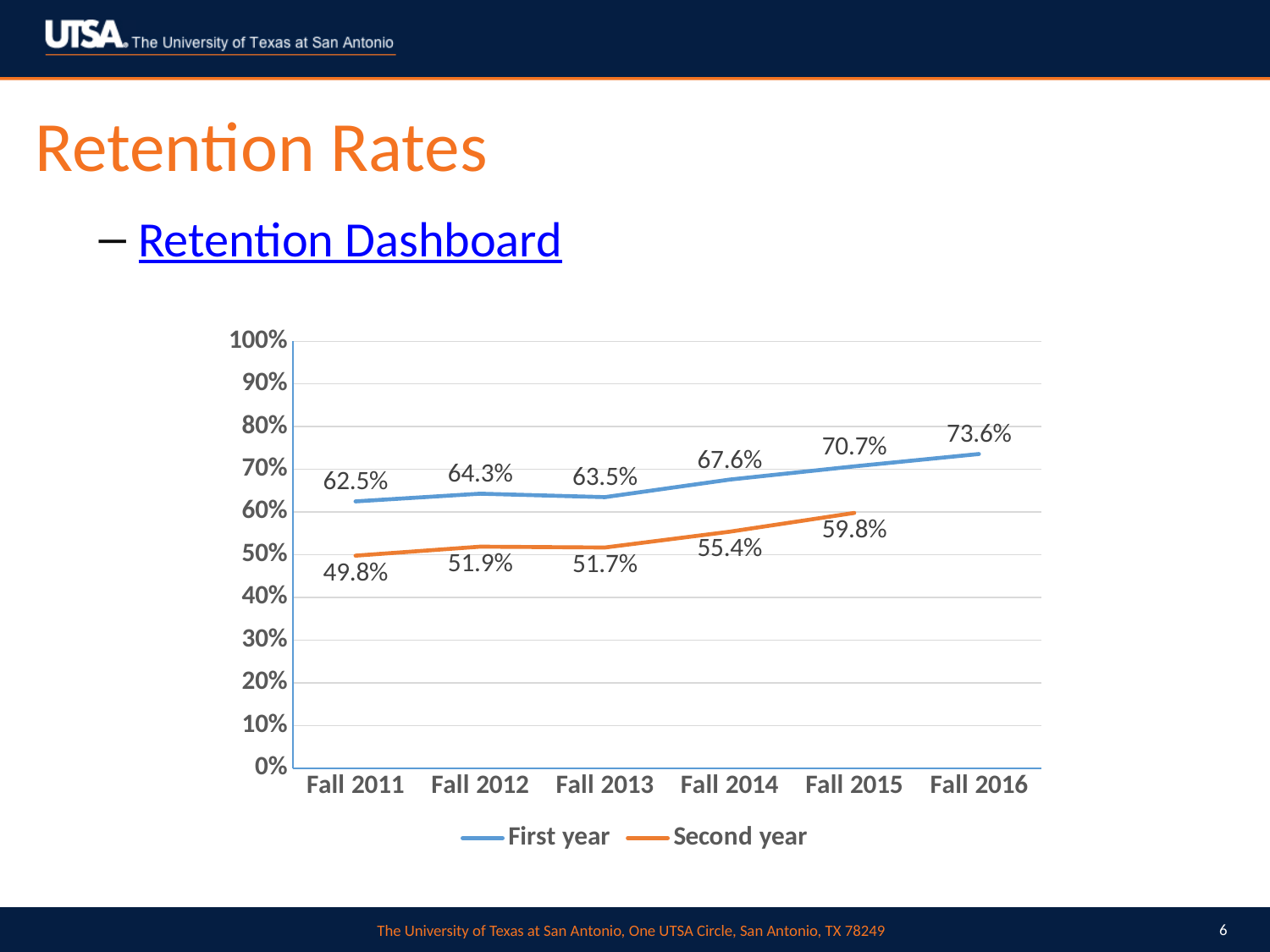
Does the First year retention rate generally rise or fall from Fall 2013 to Fall 2016? Rise What is the First year retention rate for Fall 2011? 62.5% How many series does the legend list? 2 Which series is drawn in orange? Second year What is the Second year retention rate for Fall 2014? 55.4% How many terms are shown on the x axis? 6 What kind of chart is shown on the slide? Line chart What is the difference between the First year and Second year retention rates for Fall 2015? 10.9% Which term has the lowest Second year retention rate? Fall 2011 Which is larger, the First year rate for Fall 2012 or the First year rate for Fall 2013? Fall 2012 What is the First year retention rate for Fall 2016? 73.6% Which term has the highest First year retention rate? Fall 2016